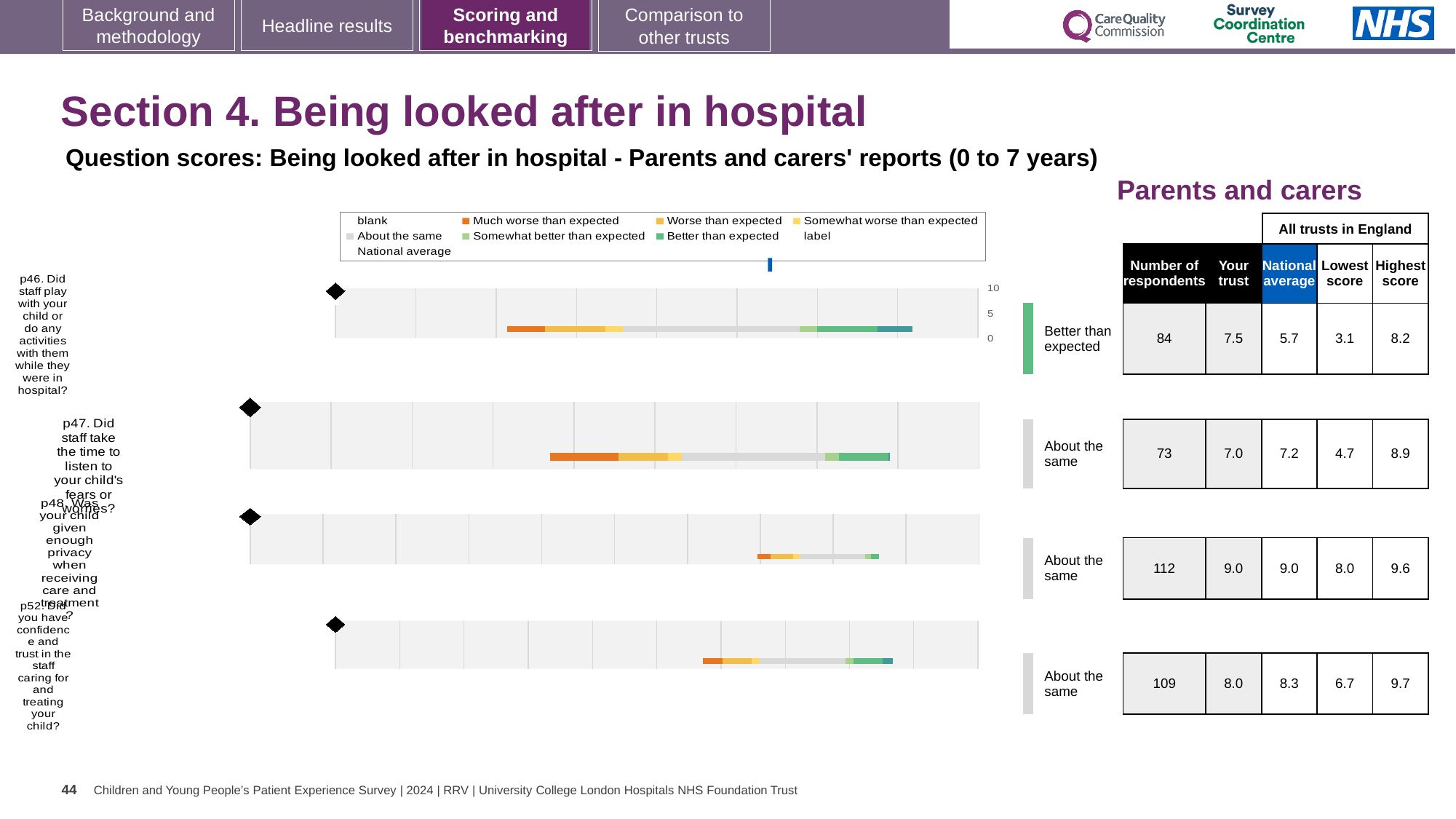
How many question charts (p46, p47, p48, p52) are shown on the slide? 4 In the chart legend, which category is shown in dark green? Better than expected For p52, what is the difference between the national average (8.3) and the 'Your trust' score (8.0)? 0.3 What kind of chart is used to show the question scores on this slide? bar chart According to the table beside the charts, what is the national average for p48 (Was your child given enough privacy when receiving care and treatment?)? 9.0 What benchmark category is shown next to the chart for p46? Better than expected What is the highest value shown on the score axis of the p46 chart? 10 Which question has the highest 'Your trust' score in the table beside the charts? p48 In the chart legend, which category is shown in orange? Much worse than expected For p47, which is larger: the 'Your trust' score or the national average? National average Which question has the lowest number of respondents in the table beside the charts? p47 According to the table beside the charts, what is the 'Your trust' score for p46 (Did staff play with your child or do any activities with them while they were in hospital?)? 7.5